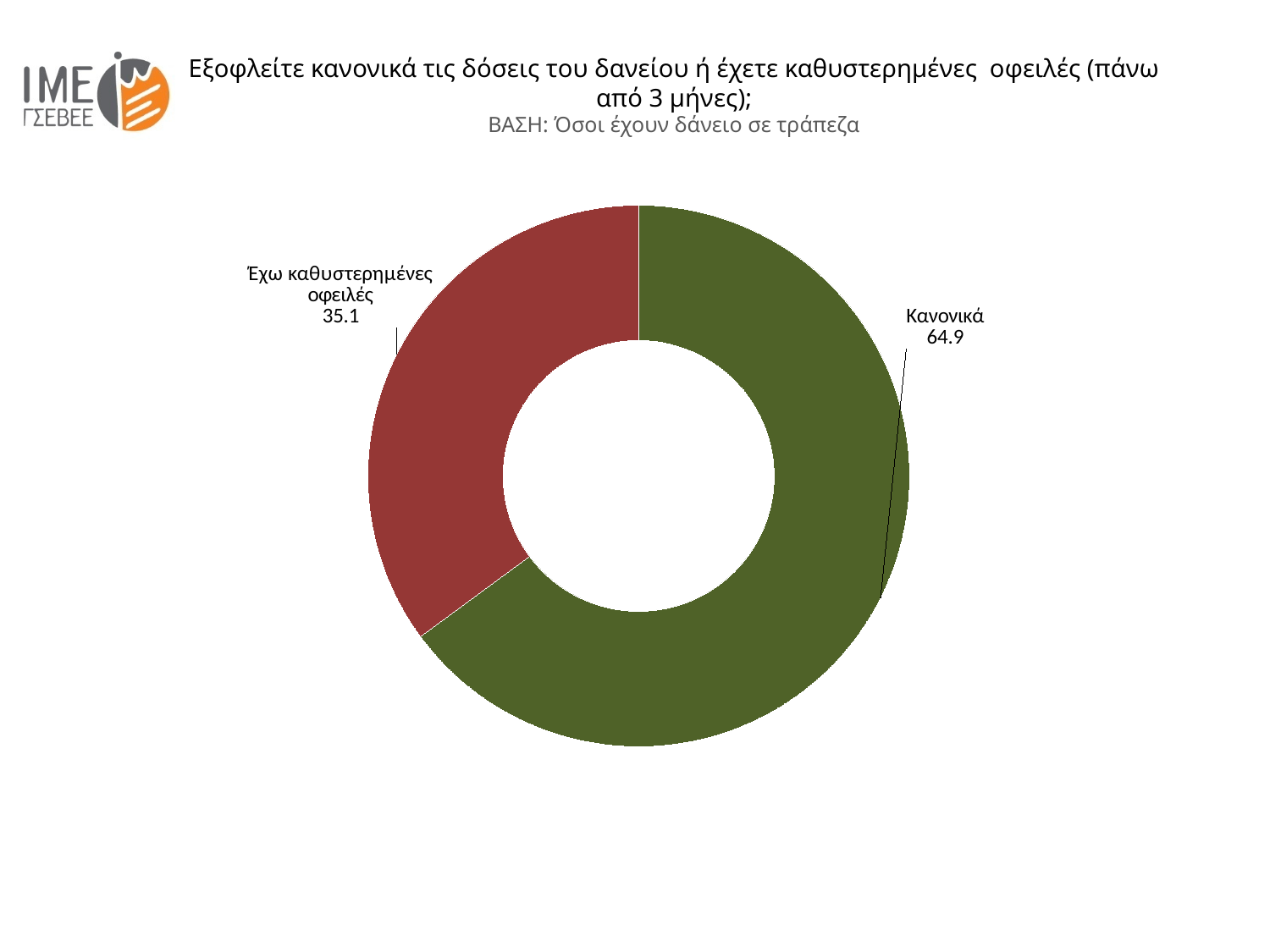
What is the total of the two values shown in the chart? 100 Which category has the highest value? Κανονικά What colour is the Έχω καθυστερημένες οφειλές slice? Red What colour is the Κανονικά slice? Green What is the difference between the values for Κανονικά and Έχω καθυστερημένες οφειλές? 29.8 What is the value for Έχω καθυστερημένες οφειλές? 35.1 What is the value for Κανονικά? 64.9 What kind of chart is shown on the slide? Doughnut (pie) chart How many categories are shown in the chart? 2 Which category has the lowest value? Έχω καθυστερημένες οφειλές Which is larger, the value for Κανονικά or the value for Έχω καθυστερημένες οφειλές? Κανονικά